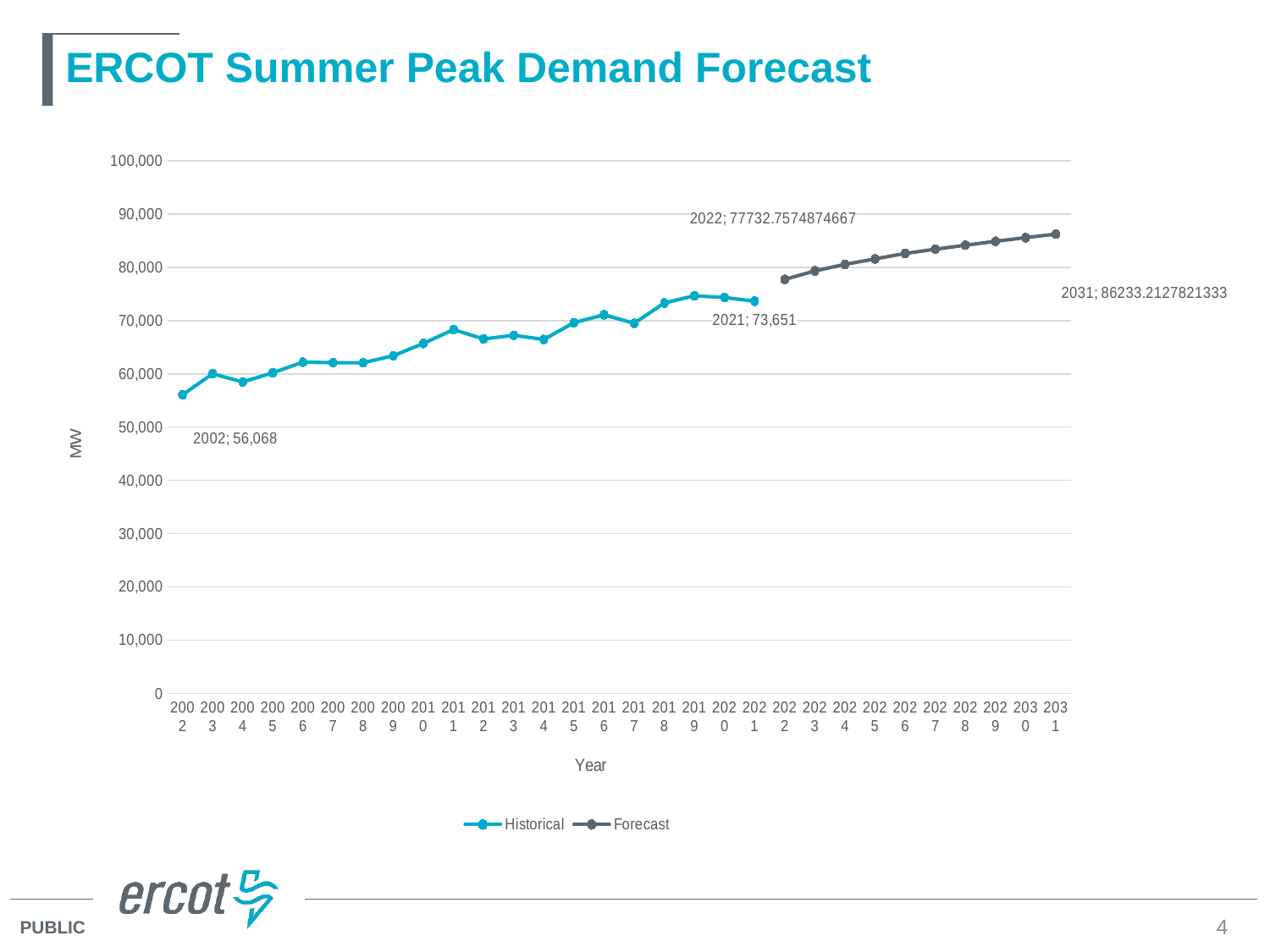
Which year has the highest value on the chart? 2031 Which year has the lowest value on the chart? 2002 What is the Forecast value labelled for 2022? 77732.7574874667 How many series does the legend list? 2 Is the Historical value for 2011 greater or less than 60,000? greater What is the Historical value for 2021? 73,651 What is the difference between the Historical values for 2021 and 2002? 17,583 What is the Historical value for 2002? 56,068 What type of chart is shown on the slide? Line chart What are the two series named in the legend? Historical and Forecast What is the Forecast value labelled for 2031? 86233.2127821333 Do the values generally rise or fall from 2002 to 2031? Rise